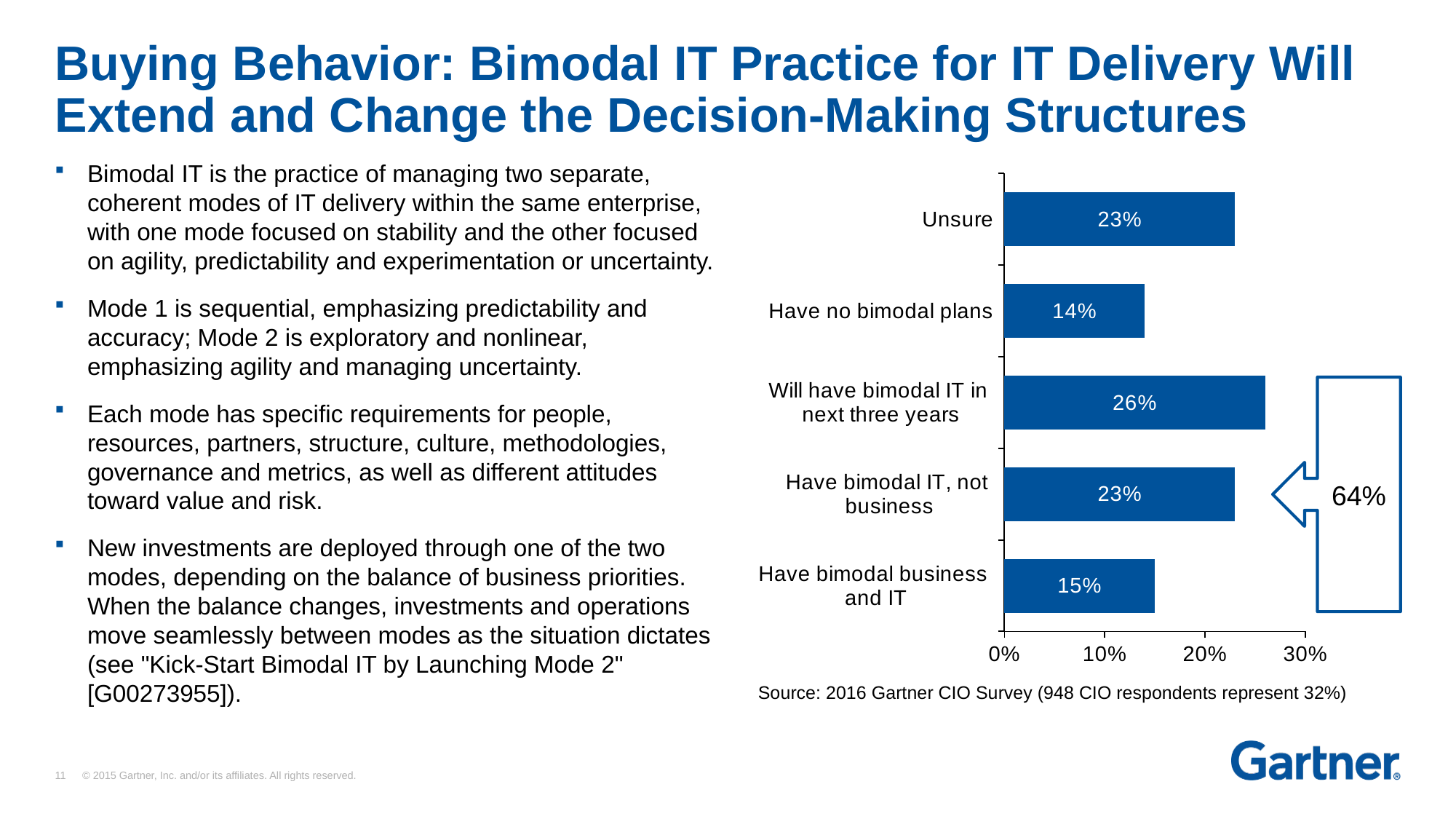
What is the total of the three categories grouped by the 64% arrow (Will have bimodal IT in next three years, Have bimodal IT not business, Have bimodal business and IT)? 64% How many categories are shown in the bar chart? 5 What percentage of respondents have bimodal business and IT? 15% What percentage of respondents answered Unsure? 23% What percentage of respondents have no bimodal plans? 14% What is the source cited below the chart? 2016 Gartner CIO Survey (948 CIO respondents represent 32%) Which category has the lowest value in the chart? Have no bimodal plans Which category has the highest value in the chart? Will have bimodal IT in next three years What percentage of respondents said they will have bimodal IT in the next three years? 26% What type of chart is shown on the slide? Bar chart What is the difference between the value for 'Will have bimodal IT in next three years' and the value for 'Have bimodal business and IT'? 11% Which is larger: the value for 'Have bimodal IT, not business' or the value for 'Have no bimodal plans'? Have bimodal IT, not business